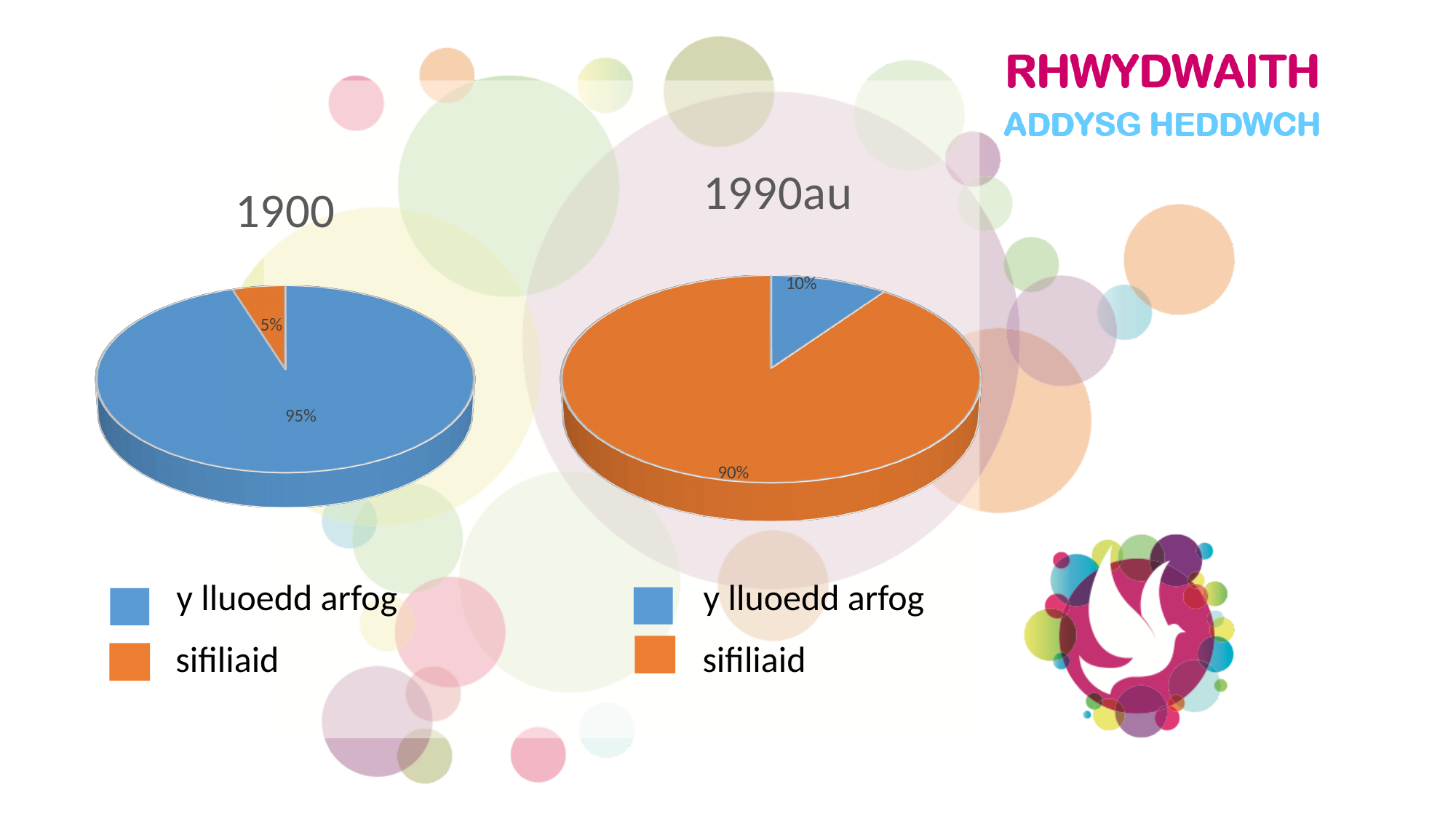
In the 1990au chart, what colour is the sifiliaid slice? orange In the 1900 chart, what share is shown for y lluoedd arfog? 95% In the 1990au chart, what share is shown for sifiliaid? 90% In the 1900 chart, what share is shown for sifiliaid? 5% In the 1990au chart, what is the difference between the sifiliaid share and the y lluoedd arfog share? 80% How many slices does the 1990au chart have? 2 In the 1900 chart, which category has the largest slice? y lluoedd arfog In the 1990au chart, what share is shown for y lluoedd arfog? 10% Which is larger: the sifiliaid share in the 1900 chart or the sifiliaid share in the 1990au chart? the 1990au chart What type of chart is the 1900 chart? pie chart In the 1990au chart, which category has the smallest slice? y lluoedd arfog How many entries does the legend under the 1900 chart list? 2